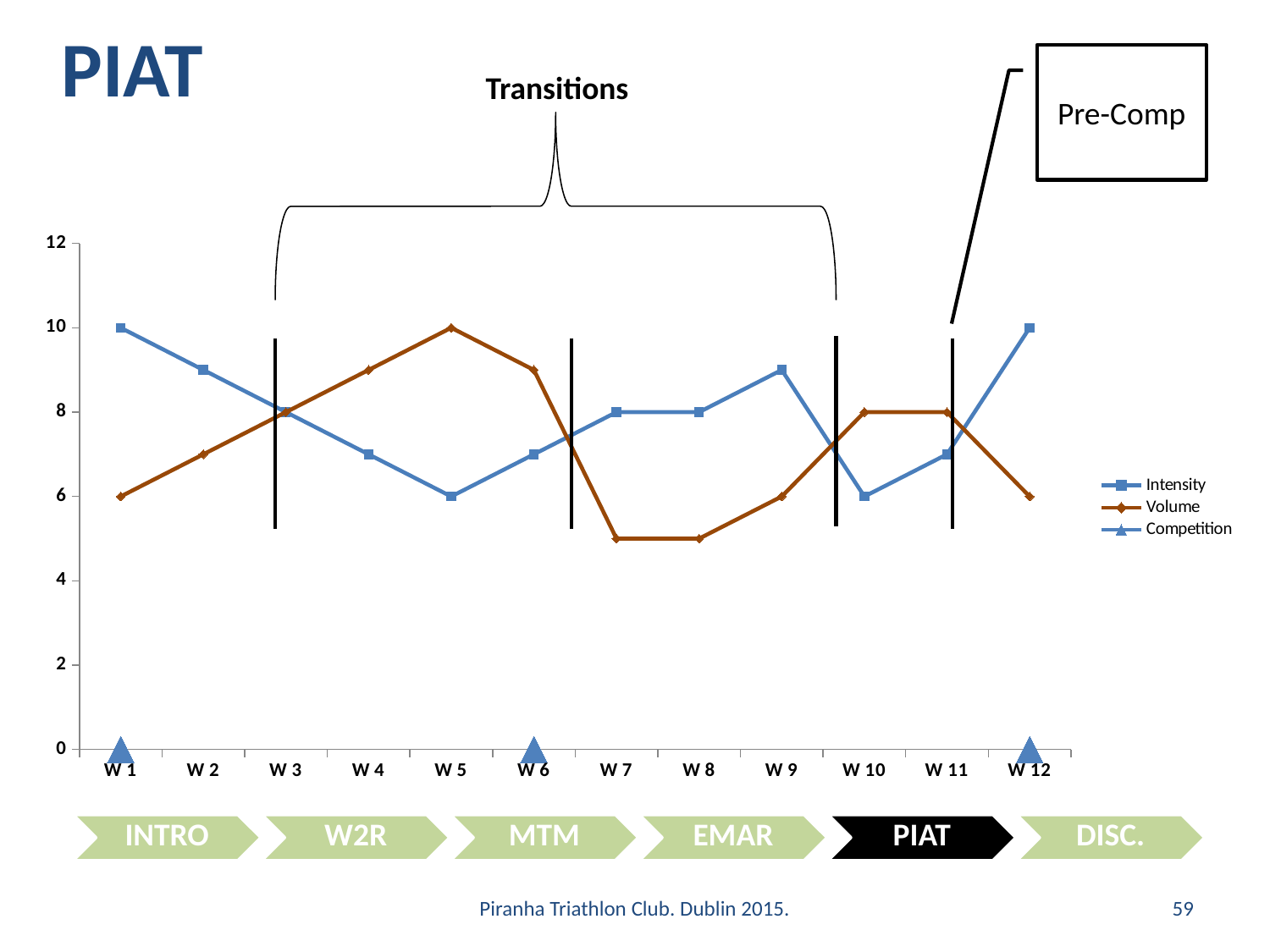
What is the Volume value at W 5? 10 Is the Volume value at W 7 greater or less than 6? less What type of chart is shown on the slide? line chart What is the Volume value at W 10? 8 How many weeks are shown along the x axis of the chart? 12 What is the Intensity value at W 1? 10 What is the difference between Volume and Intensity at W 5? 4 How many series does the chart legend list? 3 What is the Intensity value at W 5? 6 At which week does Volume reach its highest value? W 5 Does Intensity rise or fall from W 1 to W 5? fall At W 5, which is larger, Intensity or Volume? Volume